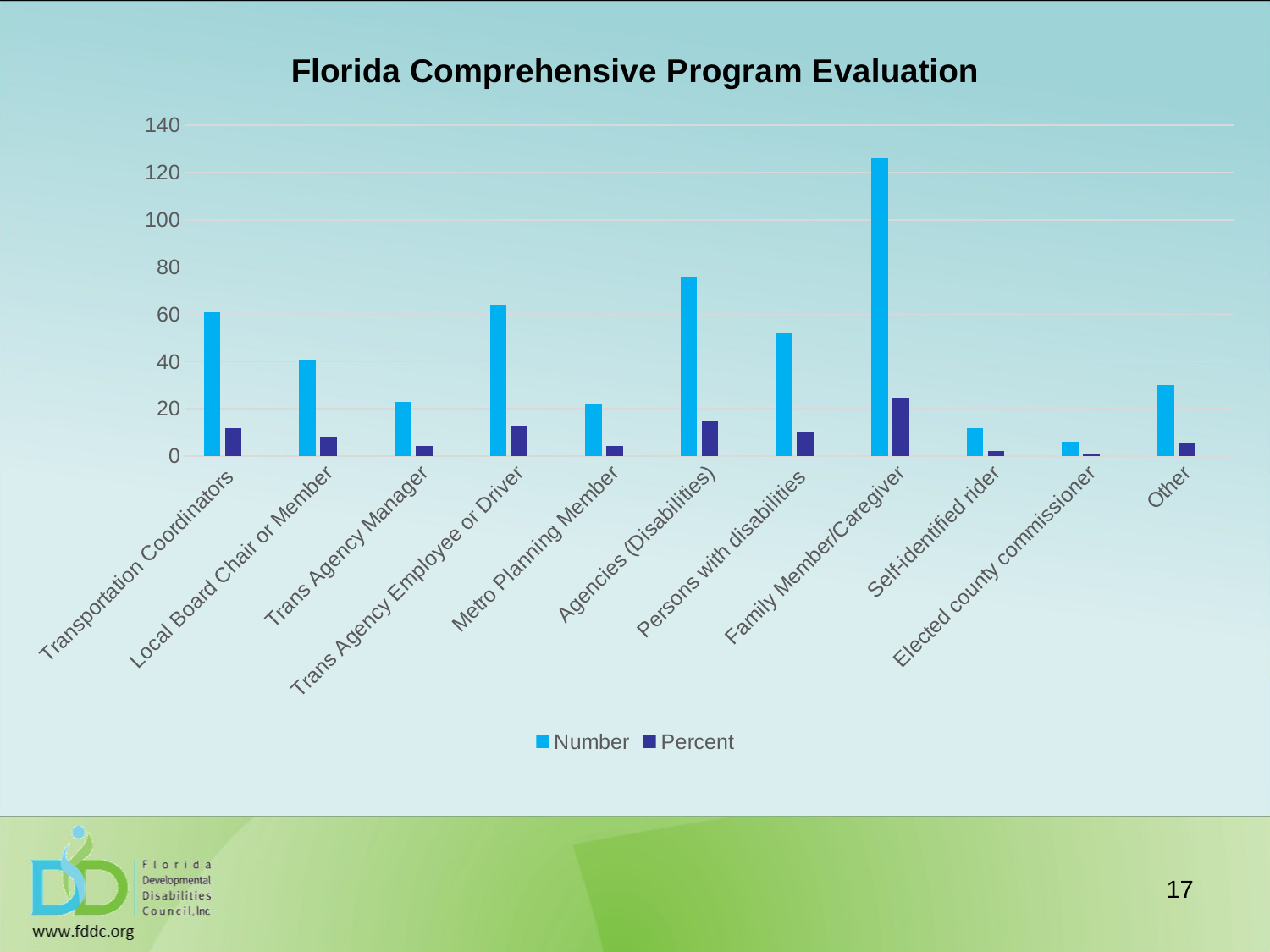
Is the Number value for Family Member/Caregiver greater or less than 120? greater What type of chart is shown on the slide? bar chart Which has a larger Number value, Agencies (Disabilities) or Persons with disabilities? Agencies (Disabilities) What is the title of the chart? Florida Comprehensive Program Evaluation Is the Number value for Metro Planning Member greater or less than 40? less Which category has the lowest Number value? Elected county commissioner How many series does the legend list? 2 Which category has the highest Number value? Family Member/Caregiver Is the Number value for Agencies (Disabilities) greater or less than 60? greater Which has a larger Number value, Transportation Coordinators or Local Board Chair or Member? Transportation Coordinators How many categories are shown on the x axis? 11